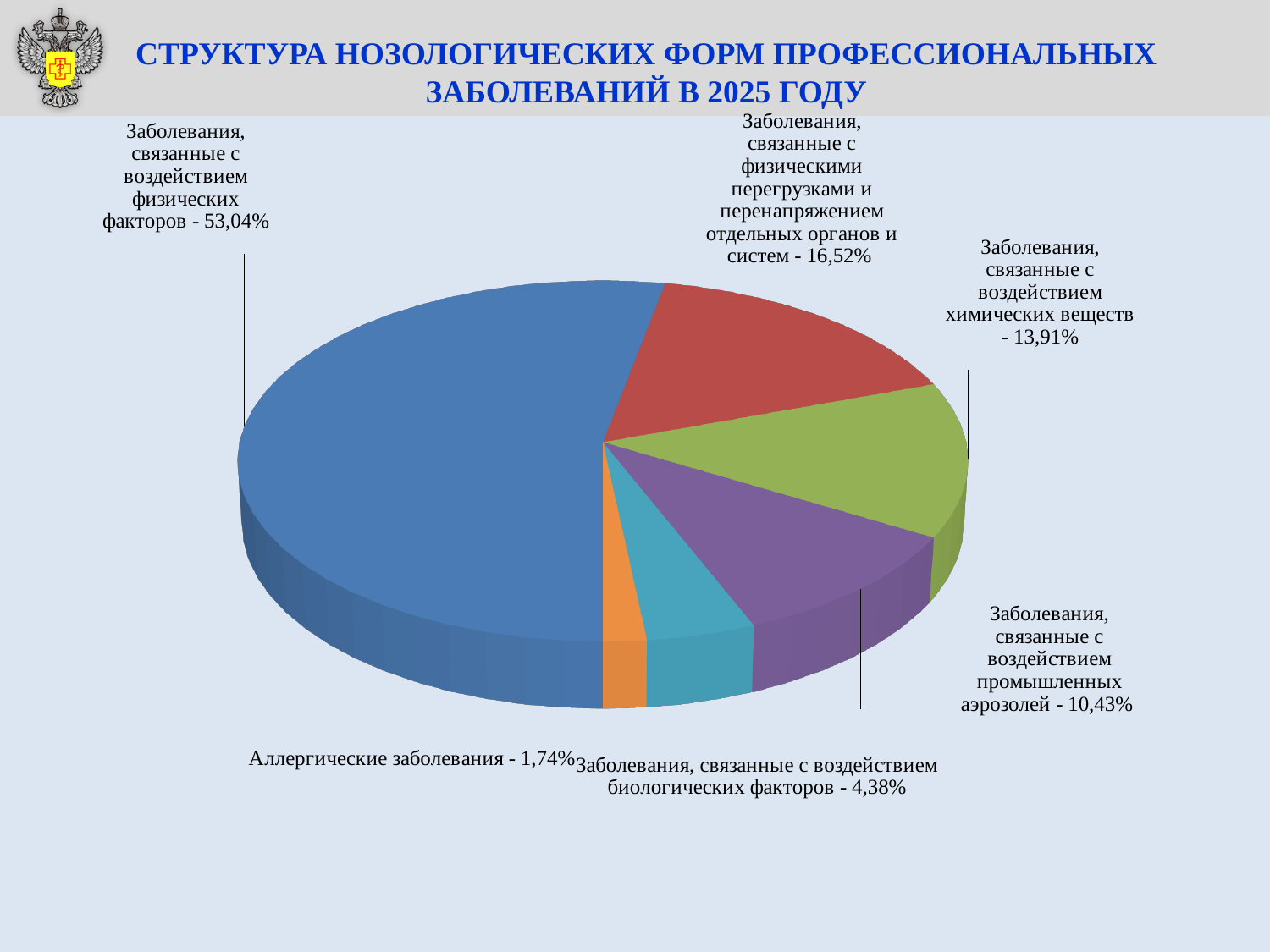
Which is larger: the share for «Заболевания, связанные с физическими перегрузками и перенапряжением отдельных органов и систем» or the share for «Заболевания, связанные с воздействием химических веществ»? Заболевания, связанные с физическими перегрузками и перенапряжением отдельных органов и систем What kind of chart is shown on the slide? Pie chart What is the difference in percentage points between the share for physical factors (53,04%) and the share for chemical substances (13,91%)? 39,13 What is the share of «Аллергические заболевания»? 1,74% Which category has the smallest share of the pie? Аллергические заболевания What is the share of «Заболевания, связанные с воздействием физических факторов»? 53,04% What is the title of the chart on the slide? СТРУКТУРА НОЗОЛОГИЧЕСКИХ ФОРМ ПРОФЕССИОНАЛЬНЫХ ЗАБОЛЕВАНИЙ В 2025 ГОДУ What is the share of «Заболевания, связанные с воздействием биологических факторов»? 4,38% What is the share of «Заболевания, связанные с воздействием промышленных аэрозолей»? 10,43% Which category has the largest share of the pie? Заболевания, связанные с воздействием физических факторов How many slices does the pie chart have? 6 What is the share of «Заболевания, связанные с воздействием химических веществ»? 13,91%